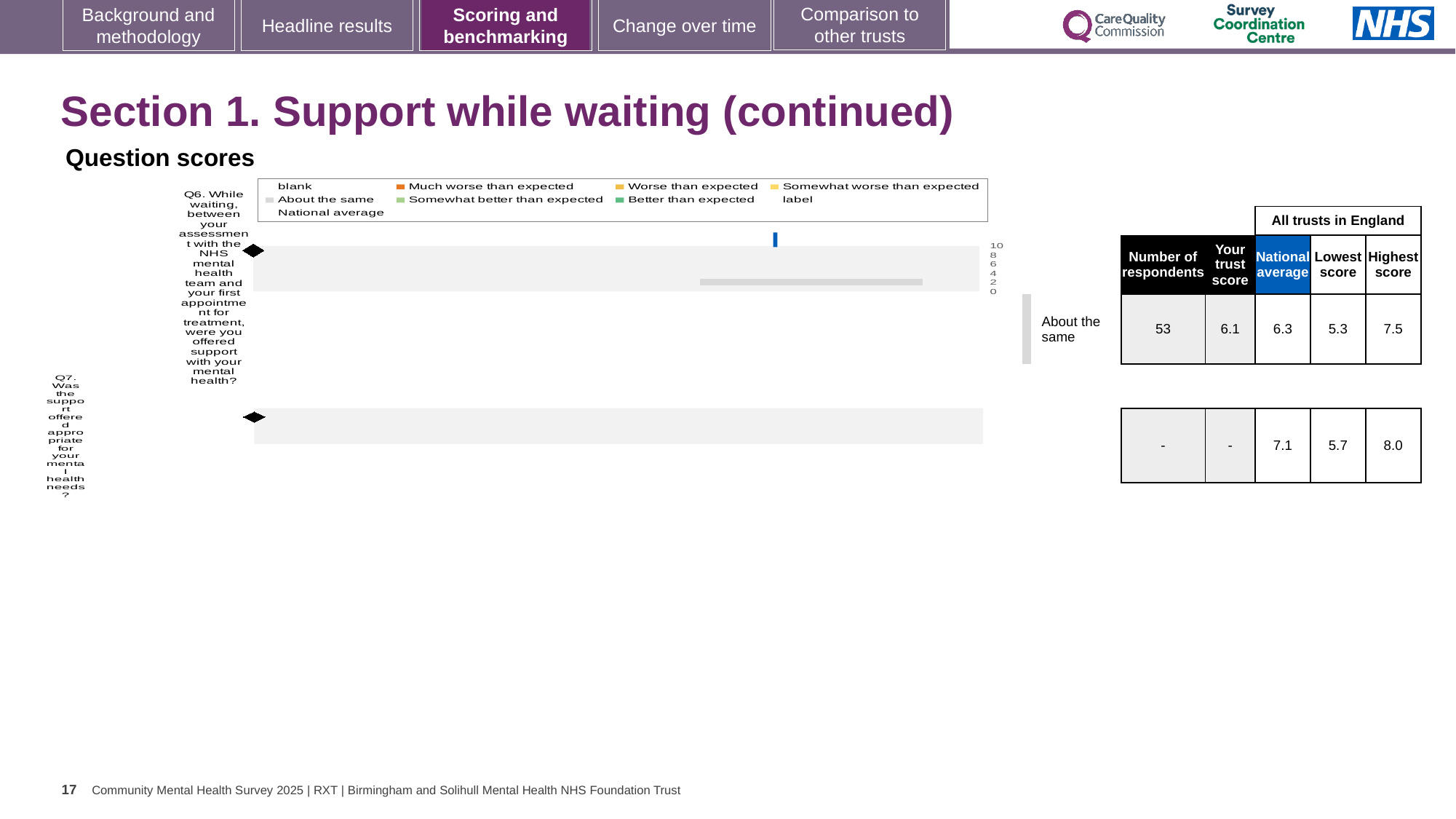
What is the lowest score among all trusts in England for Q7? 5.7 What benchmark category label is shown for Q6 on the chart? About the same What is the national average score for Q7? 7.1 How many questions (categories) are plotted on the chart? 2 What is the difference between the highest and lowest scores for Q7? 2.3 What is the difference between the highest and lowest scores for Q6? 2.2 What is the national average score for Q6? 6.3 What is the highest score among all trusts in England for Q6? 7.5 What is the trust's score for Q6? 6.1 How many respondents answered Q6 according to the table next to the chart? 53 For Q6, which is larger: the trust's score or the national average? national average What kind of chart is shown on the slide? bar chart